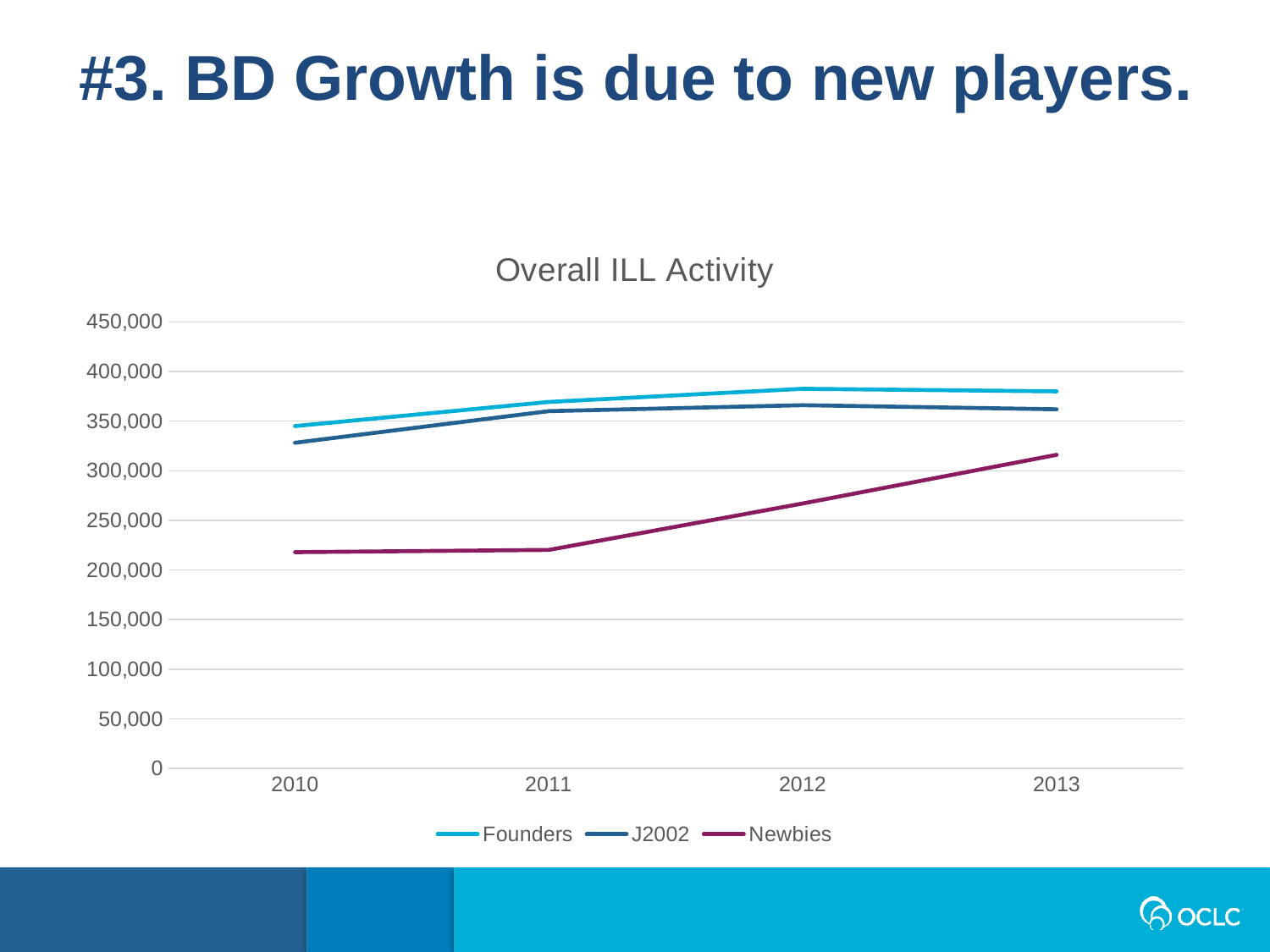
Do the values for Newbies rise or fall from 2010 to 2013? rise Which series is plotted with the dark red/purple line? Newbies Is the value for Founders in 2012 greater or less than 400,000? less Is the value for Newbies in 2010 greater or less than 250,000? less How many years are shown on the x axis? 4 What is the title of the chart? Overall ILL Activity How many series does the legend list? 3 In 2013, which is larger, the value for J2002 or the value for Newbies? J2002 Is the value for Newbies in 2013 greater or less than 300,000? greater What kind of chart is shown on the slide? line chart Which series has the highest value in 2013? Founders Which series has the lowest value in 2010? Newbies